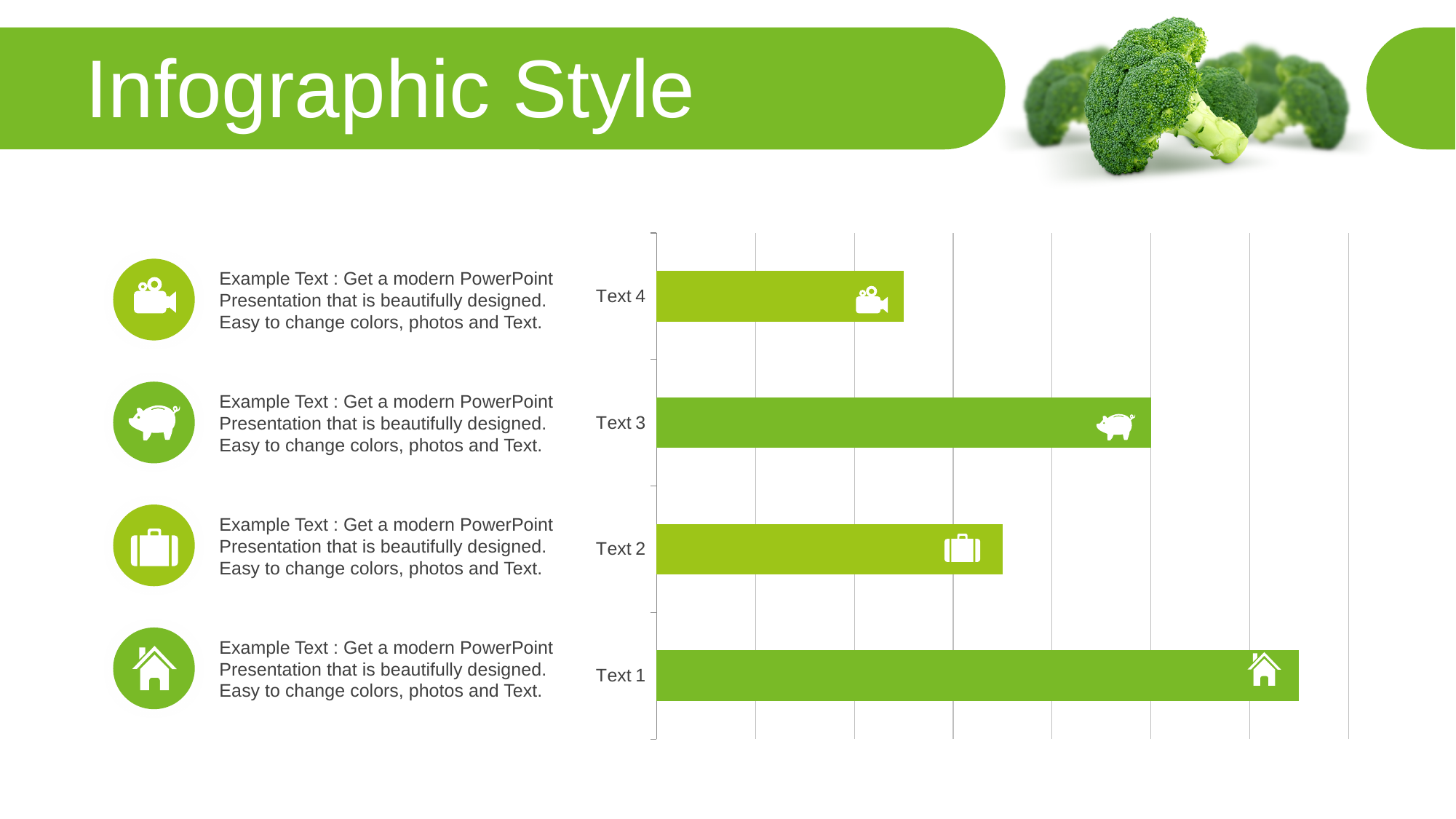
Which icon appears on the Text 1 bar? A house Which bar is longer, Text 1 or Text 3? Text 1 Which category is listed at the top of the chart? Text 4 Which bar is longer, Text 2 or Text 4? Text 2 Which category has the shortest bar in the chart? Text 4 Which category has the longest bar in the chart? Text 1 Which bar is longer, Text 3 or Text 2? Text 3 What kind of chart is shown on the slide? Bar chart How many bars does the chart have? 4